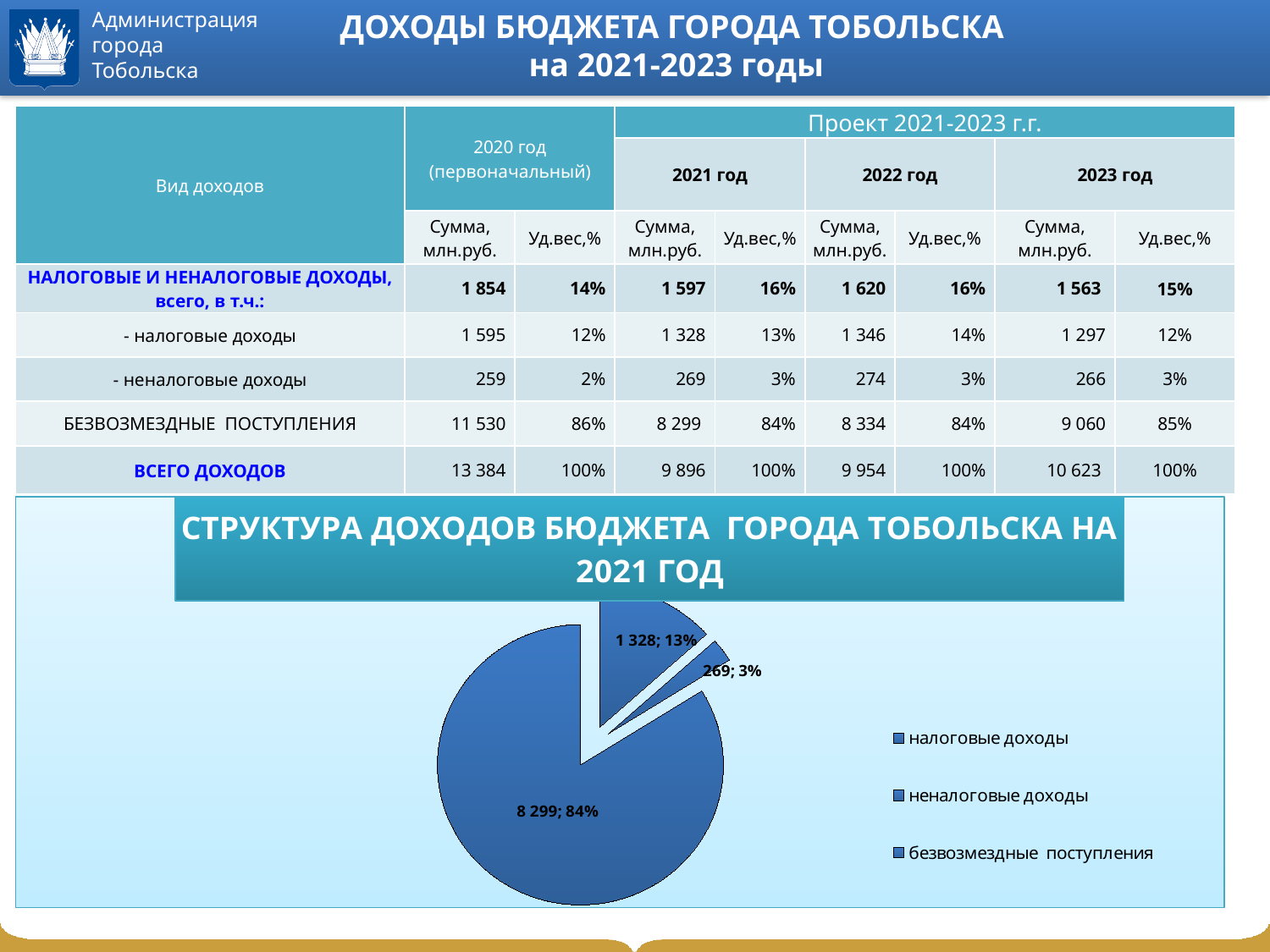
What value is shown for налоговые доходы in the pie chart? 1 328 What share of the pie does безвозмездные поступления take? 84% What share of the pie does налоговые доходы take? 13% What value is shown for неналоговые доходы in the pie chart? 269 How many entries does the pie chart's legend list? 3 What is the title of the pie chart? СТРУКТУРА ДОХОДОВ БЮДЖЕТА ГОРОДА ТОБОЛЬСКА НА 2021 ГОД In the pie chart, what is the difference between the values for налоговые доходы and неналоговые доходы? 1 059 How many slices does the pie chart have? 3 What kind of chart is shown on the slide? pie chart What value is shown for безвозмездные поступления in the pie chart? 8 299 Which slice of the pie chart is the smallest? неналоговые доходы Which slice of the pie chart is the largest? безвозмездные поступления